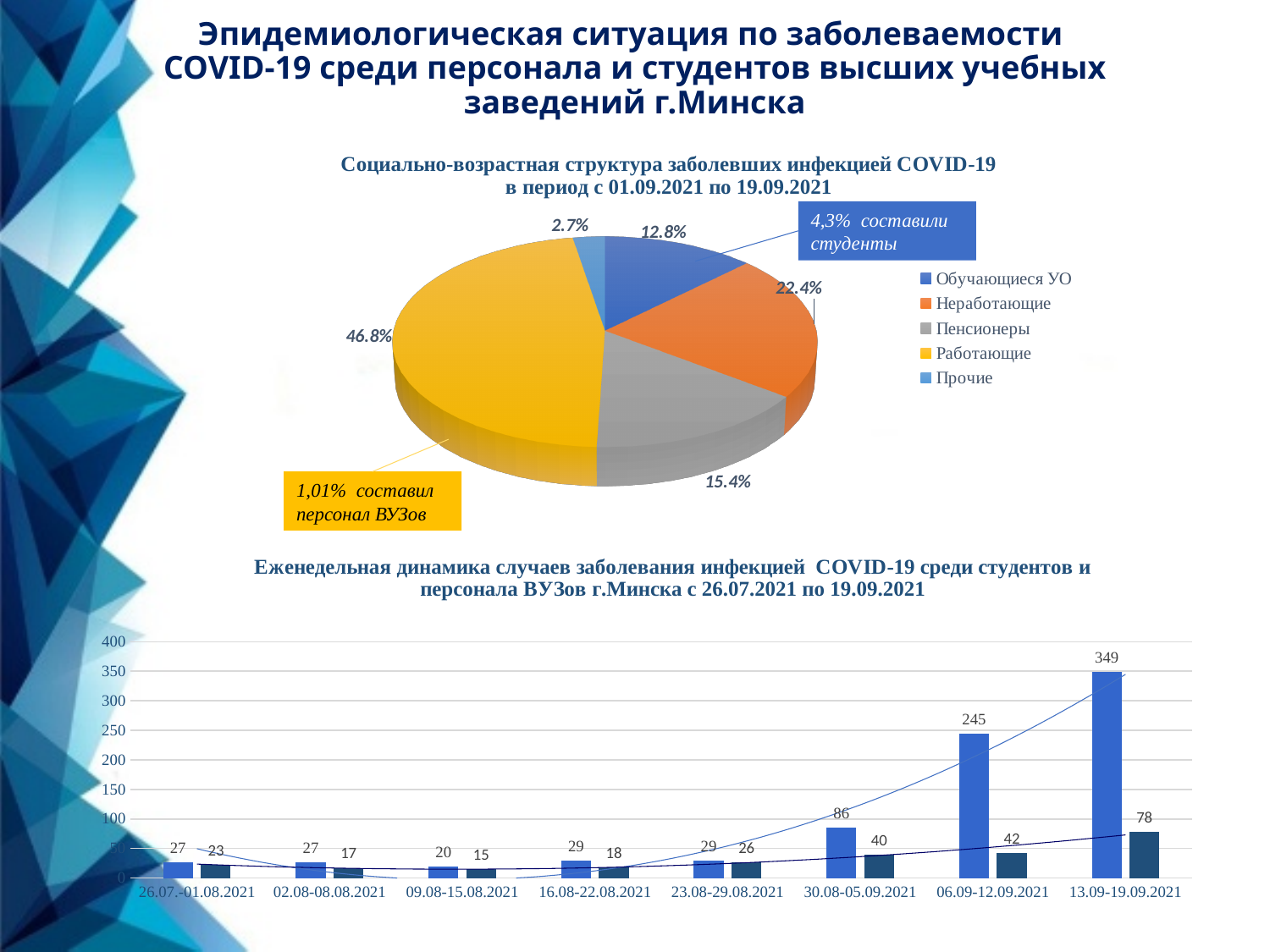
In the bar chart 'Еженедельная динамика случаев заболевания инфекцией COVID-19', do the light blue bar values rise or fall from 30.08-05.09.2021 to 13.09-19.09.2021? rise In the bar chart 'Еженедельная динамика случаев заболевания инфекцией COVID-19', what is the value of the light blue bar for the week 13.09-19.09.2021? 349 In the pie chart 'Социально-возрастная структура заболевших инфекцией COVID-19', what is the difference between the 'Неработающие' and 'Пенсионеры' shares? 7.0% In the pie chart 'Социально-возрастная структура заболевших инфекцией COVID-19', what share does the 'Работающие' slice have? 46.8% In the bar chart 'Еженедельная динамика случаев заболевания инфекцией COVID-19', what is the value of the dark blue bar for the week 06.09-12.09.2021? 42 In the pie chart 'Социально-возрастная структура заболевших инфекцией COVID-19', which category has the smallest share? Прочие In the bar chart 'Еженедельная динамика случаев заболевания инфекцией COVID-19', what is the difference between the light blue bars for 13.09-19.09.2021 and 06.09-12.09.2021? 104 In the bar chart 'Еженедельная динамика случаев заболевания инфекцией COVID-19', how many weekly periods are shown on the x axis? 8 In the pie chart 'Социально-возрастная структура заболевших инфекцией COVID-19', how many categories does the legend list? 5 In the pie chart 'Социально-возрастная структура заболевших инфекцией COVID-19', what share does the 'Неработающие' slice have? 22.4% What type of chart is the lower chart 'Еженедельная динамика случаев заболевания инфекцией COVID-19'? bar chart In the pie chart 'Социально-возрастная структура заболевших инфекцией COVID-19', which category has the largest share? Работающие